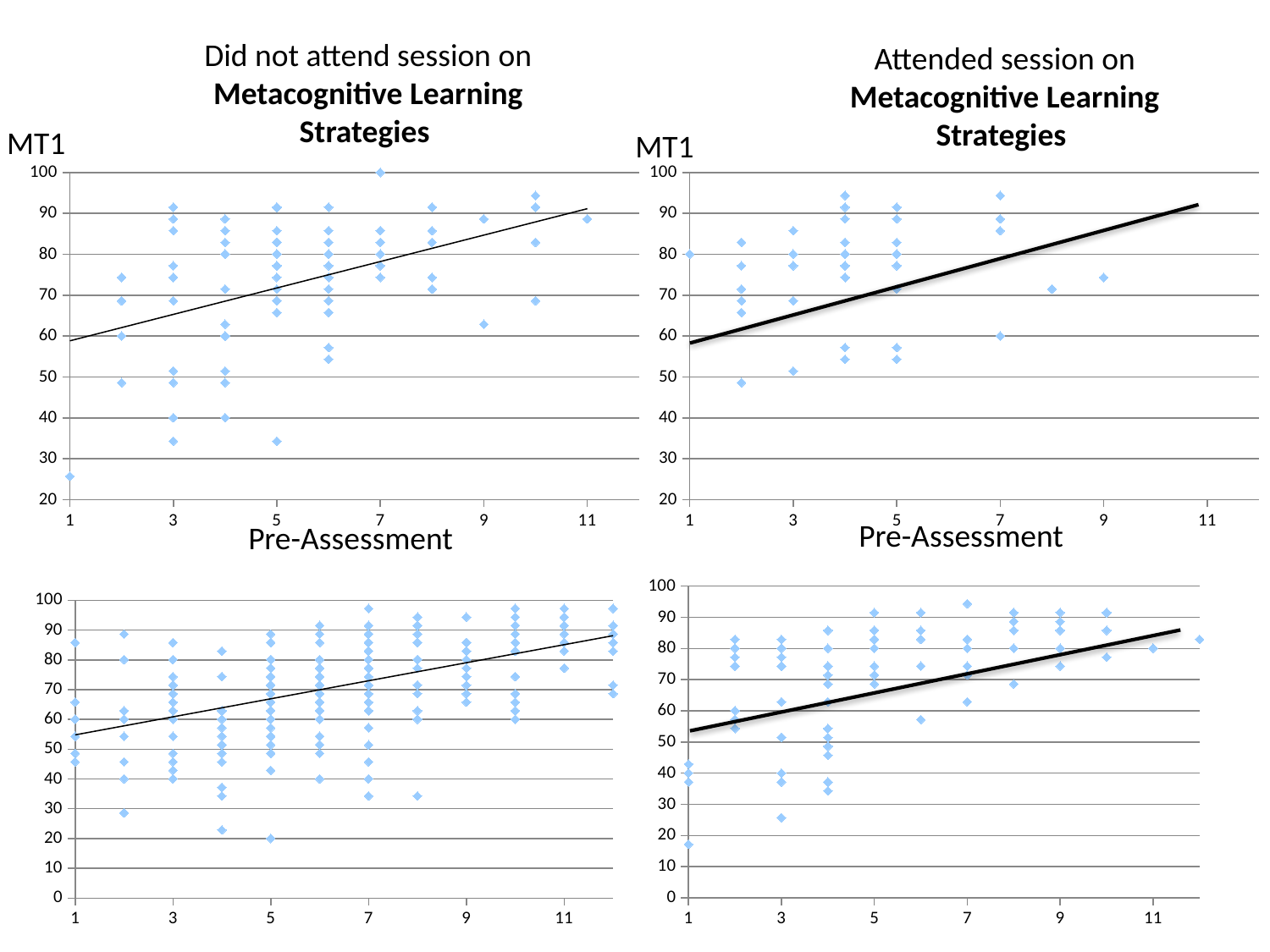
What is the label on the vertical axis of the top two charts? MT1 In the bottom-right chart, does the trend line rise or fall along the x axis? Rises What kind of chart is the top-right chart titled 'Attended session on Metacognitive Learning Strategies'? Scatter chart In the bottom-right chart, is the lowest point at x = 3 greater or less than 30? less In the bottom-right chart, is the lowest point at x = 1 greater or less than 20? less What kind of chart is the top-left chart titled 'Did not attend session on Metacognitive Learning Strategies'? Scatter chart In the top-right chart ('Attended session'), is the highest point at Pre-Assessment 4 greater or less than 90? greater In the top-left chart ('Did not attend session'), does the trend line rise or fall as Pre-Assessment increases? Rises What is the label on the horizontal axis of the top two charts? Pre-Assessment In the top-right chart ('Attended session'), does the trend line rise or fall as Pre-Assessment increases? Rises